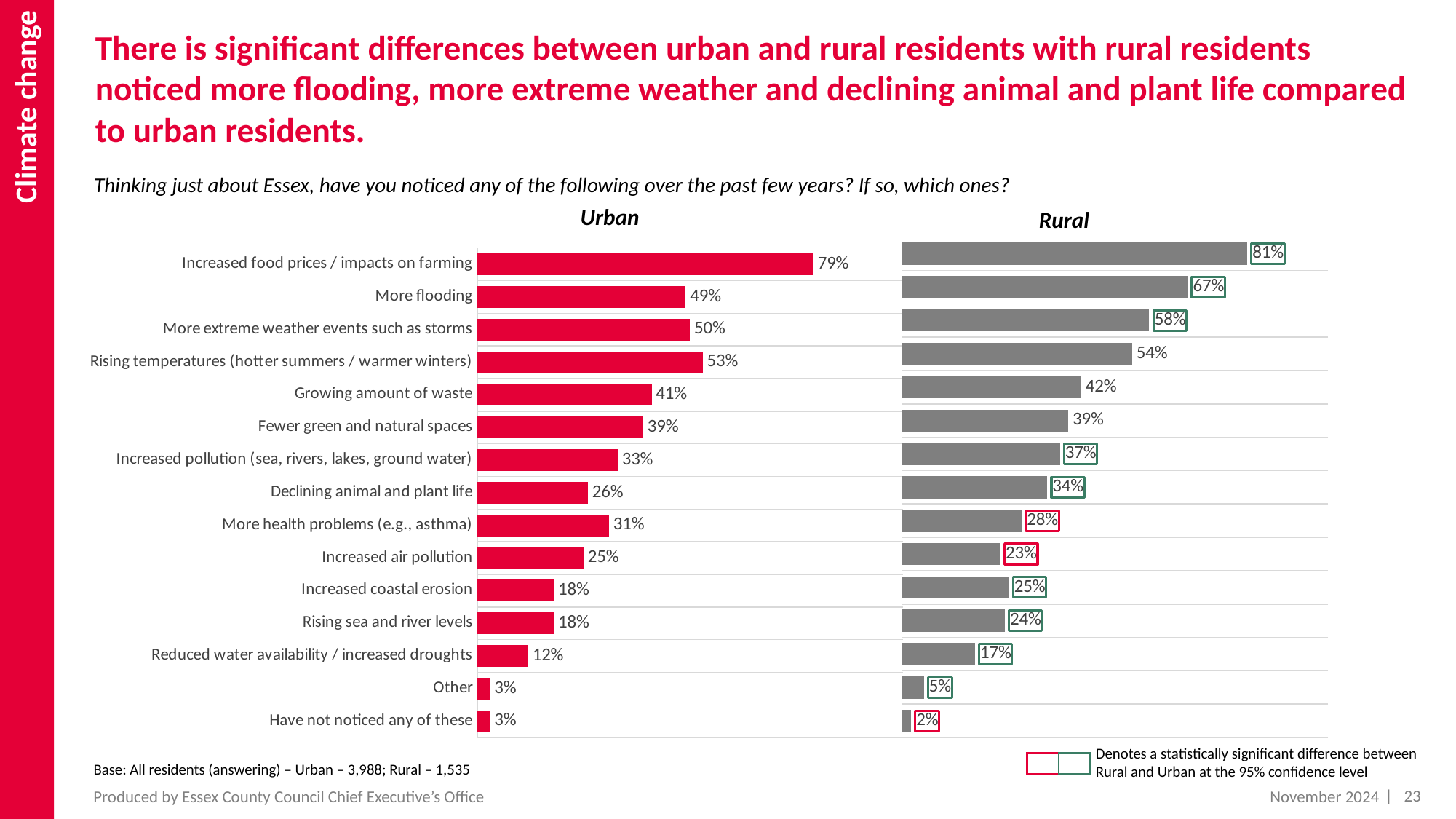
In the Urban chart, what is the value for rising temperatures (hotter summers / warmer winters)? 53% What type of chart is used to show the Urban results? Bar chart In the Rural chart, which category has the highest value? Increased food prices / impacts on farming Which is larger: the Urban value for more health problems (e.g., asthma) or the Rural value for more health problems (e.g., asthma)? Urban In the Rural chart, which category has the lowest value? Have not noticed any of these What colour are the bars in the Rural chart? Grey In the Rural chart, what is the value for declining animal and plant life? 34% In the Rural chart, what percentage of respondents noticed more flooding? 67% What is the difference between the Rural and Urban values for more flooding? 18 percentage points How many categories are shown in the Urban chart? 15 What is the difference between the Urban values for increased food prices / impacts on farming and reduced water availability / increased droughts? 67 percentage points In the Urban chart, what percentage of respondents noticed increased food prices / impacts on farming? 79%